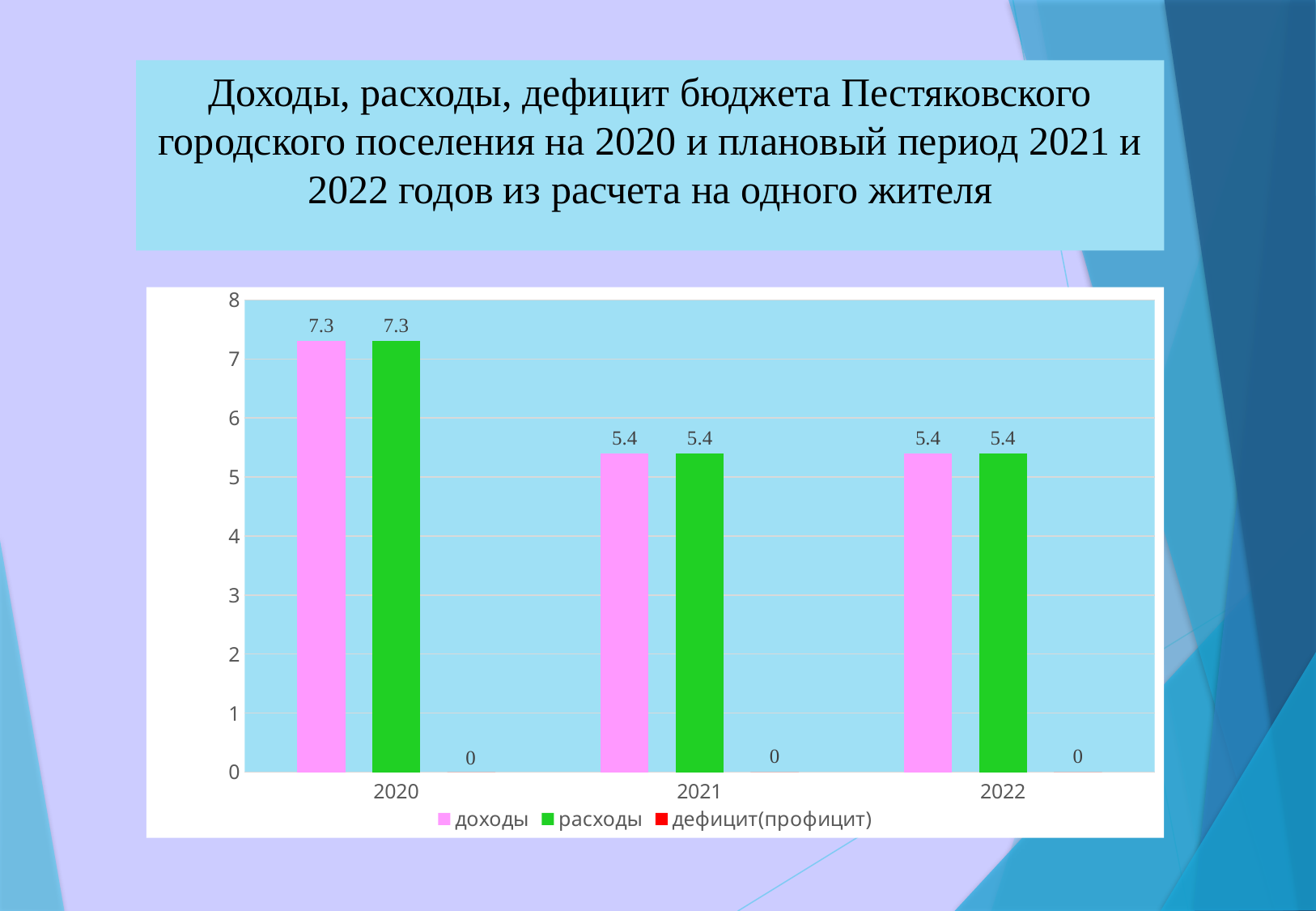
Do the values of доходы rise or fall from 2020 to 2021? fall What is the value of дефицит(профицит) for 2022? 0 Is the value of расходы for 2021 greater or less than 6? less Which is larger: расходы in 2020 or расходы in 2022? расходы in 2020 What is the value of расходы for 2021? 5.4 What is the difference between доходы in 2020 and доходы in 2021? 1.9 What is the value of доходы for 2020? 7.3 What colour are the bars for расходы? green How many years are shown on the x axis? 3 How many series does the legend list? 3 What kind of chart is shown on the slide? bar chart In which year is доходы highest? 2020